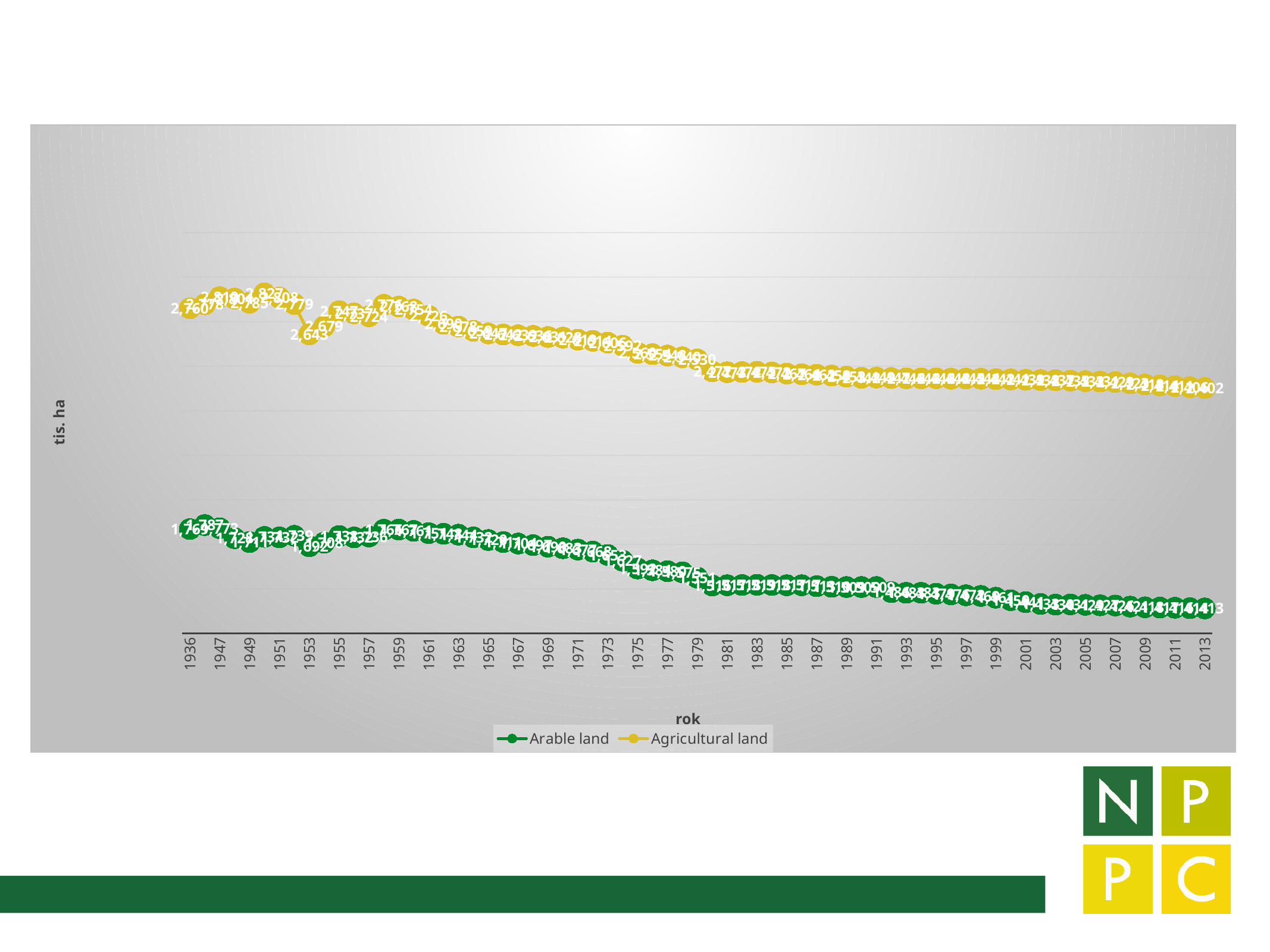
Overall, does the Arable land series rise or fall from 1936 to 2013? fall What are the two series named in the legend? Arable land and Agricultural land What is the value of Agricultural land in 1953? 2,643 What is the label of the x axis? rok Which series has the larger value in 1936, Arable land or Agricultural land? Agricultural land Overall, does the Agricultural land series rise or fall from 1959 to 2013? fall What is the value of Agricultural land in 1936? 2,760 Between 1936 and 1959, which year has the lowest Agricultural land value? 1953 What kind of chart is shown on the slide? line chart How many series does the legend list? 2 Which series has the larger value in 2013, Arable land or Agricultural land? Agricultural land